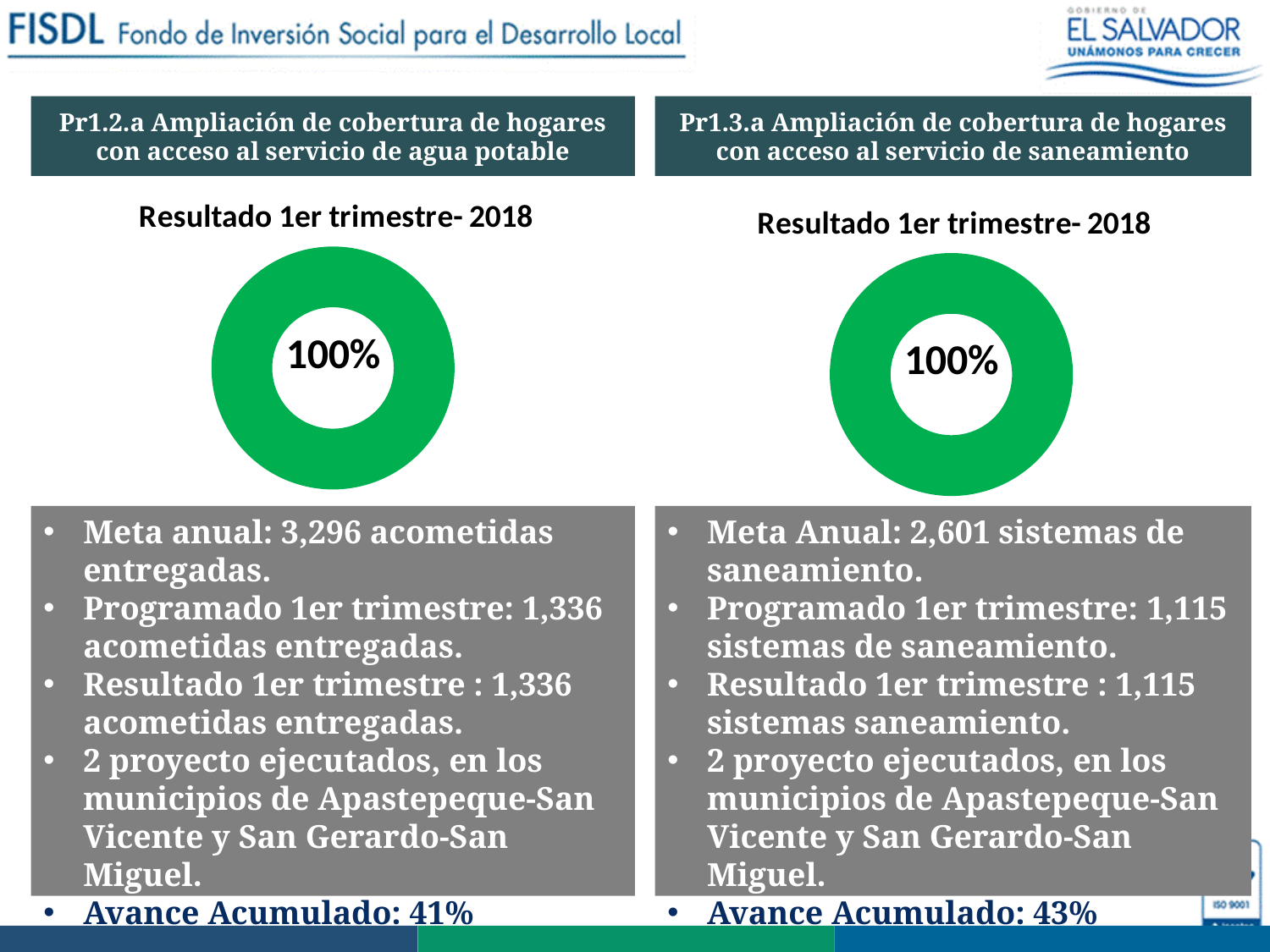
What is the title shown above the left chart (agua potable)? Resultado 1er trimestre- 2018 What kind of chart is shown on the right side of the slide under 'Pr1.3.a Ampliación de cobertura de hogares con acceso al servicio de saneamiento'? Doughnut chart What colour is the filled ring of the right chart (saneamiento)? Green In the left chart (agua potable), is the value shown greater or less than 50%? greater What kind of chart is shown on the left side of the slide under 'Pr1.2.a Ampliación de cobertura de hogares con acceso al servicio de agua potable'? Doughnut chart How many doughnut charts are shown on the slide? 2 In the left chart (agua potable), what share of the doughnut does the green segment occupy? 100% In the left chart (agua potable), what percentage is shown in the centre of the doughnut? 100% In the right chart (saneamiento), is the value shown greater or less than 50%? greater In the right chart (saneamiento), what percentage is shown in the centre of the doughnut? 100%